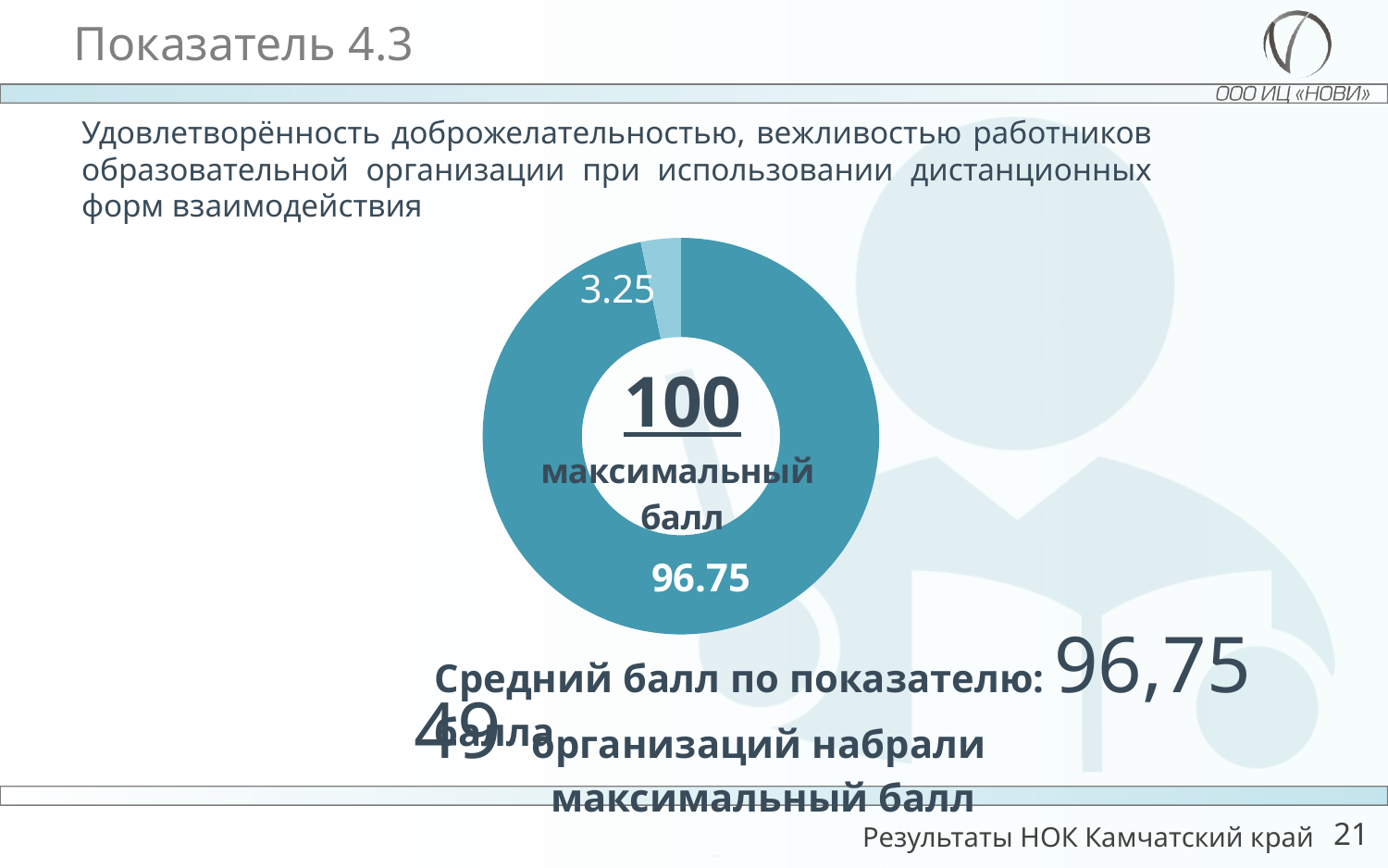
What value is labelled on the small light slice of the doughnut chart? 3.25 What is the smallest value shown on the doughnut chart? 3.25 What value is labelled on the large dark teal slice of the doughnut chart? 96.75 What is the total of the two slice values on the doughnut chart? 100 What is the largest value shown on the doughnut chart? 96.75 What is the difference between the two slice values on the doughnut chart (96.75 and 3.25)? 93.5 What text appears below the number 100 in the centre of the doughnut chart? максимальный балл Which slice is larger on the doughnut chart, the one labelled 96.75 or the one labelled 3.25? 96.75 What number is printed in the centre of the doughnut chart? 100 What kind of chart is shown on the slide? doughnut (pie) chart What share of the whole doughnut does the slice labelled 3.25 represent? 3.25% How many slices does the doughnut chart have? 2